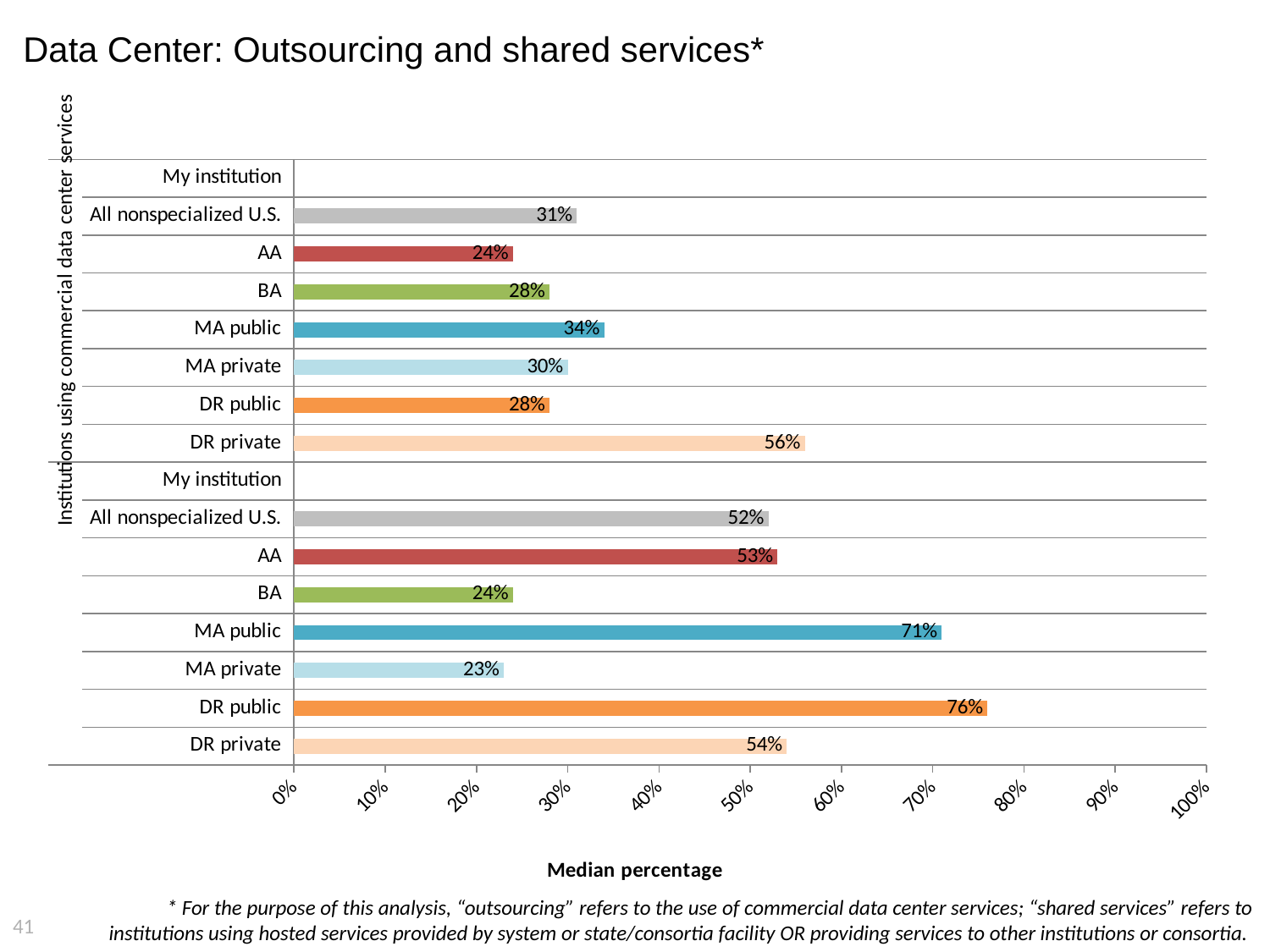
Which category has the highest value in the lower group of bars? DR public Which category has the lowest value in the upper group of bars? AA What is the label of the x axis? Median percentage In the upper group of bars, what is the value for DR private? 56% What is the title of the slide? Data Center: Outsourcing and shared services* In the lower group of bars, what is the value for MA private? 23% In the lower group of bars, which is larger: the value for AA or the value for BA? AA In the upper group of bars, what is the value for All nonspecialized U.S.? 31% In the lower group of bars, what is the value for MA public? 71% What kind of chart is shown on the slide? bar chart What is the difference between the DR public value in the lower group (76%) and the DR public value in the upper group (28%)? 48% Is the value for MA public in the lower group of bars greater or less than 60%? greater